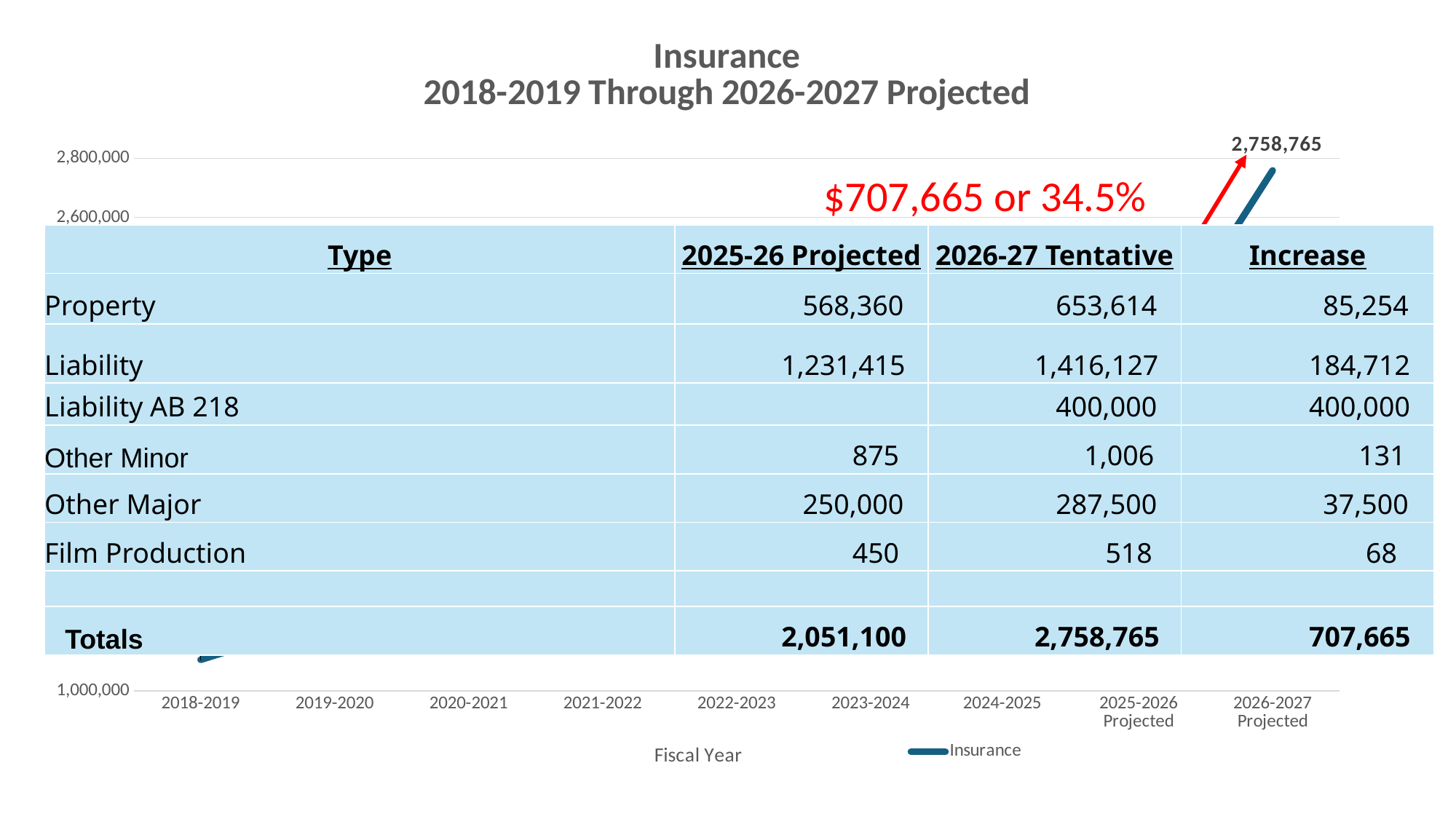
What kind of chart is shown on the slide? line chart What is the title of the chart? Insurance 2018-2019 Through 2026-2027 Projected How many series does the chart legend list? 1 What is the highest tick value shown on the y axis? 2,800,000 What is the first fiscal year shown on the x axis? 2018-2019 Does the line rise or fall between 2025-2026 Projected and 2026-2027 Projected? rise What series name appears in the chart legend? Insurance How many fiscal years are shown on the x axis of the chart? 9 What is the value plotted for 2026-2027 Projected? 2,758,765 Is the value for 2026-2027 Projected greater or less than 2,600,000? greater